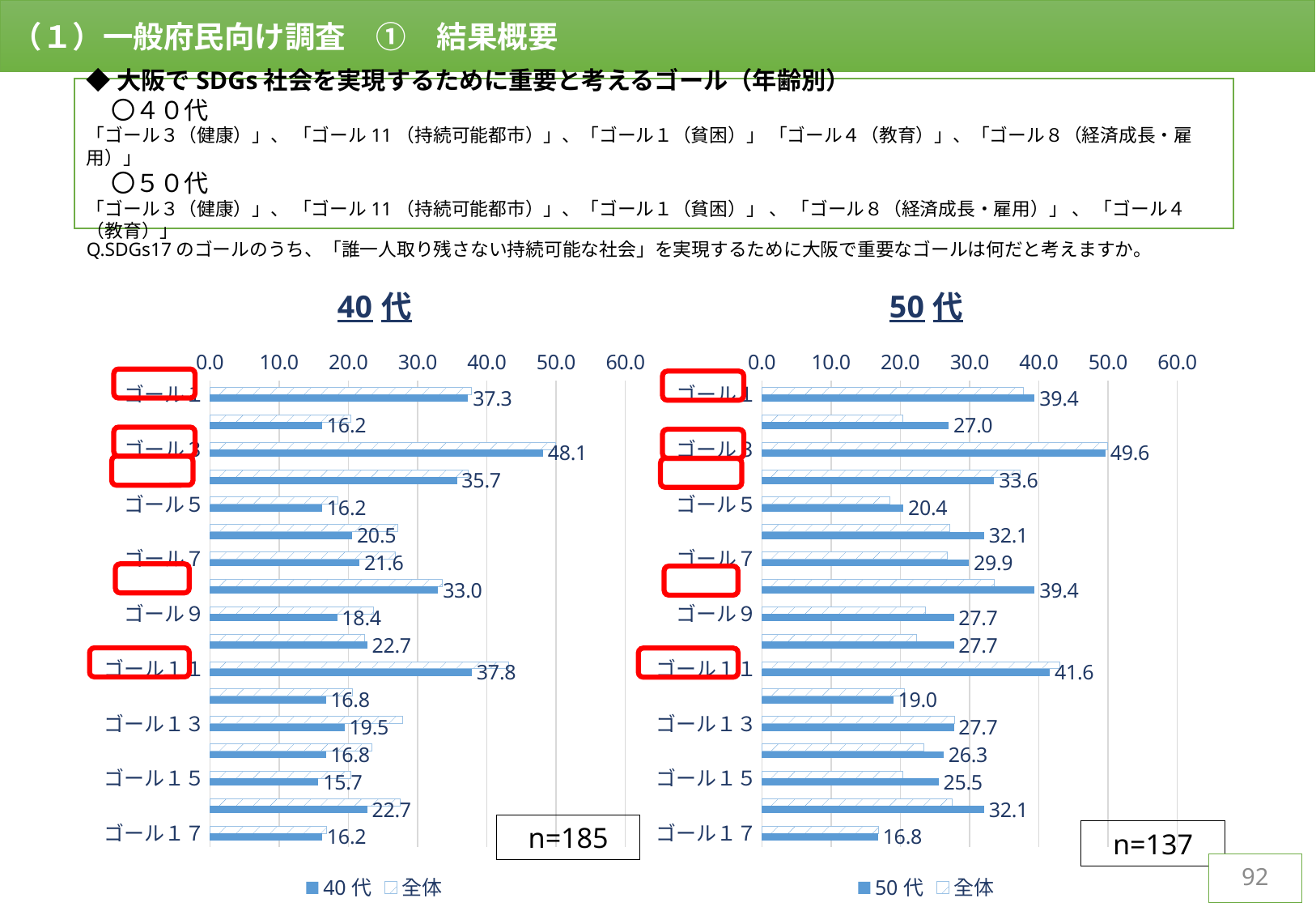
In the 40代 chart, what is the difference between the 40代 values for ゴール3 and ゴール1? 10.8 In the 40代 chart, what is the value for ゴール13 in the 40代 series? 19.5 In the 40代 chart, what is the value for ゴール11 in the 40代 series? 37.8 In the 50代 chart, is the 全体 value for ゴール17 greater or less than 20.0? less In the 50代 chart, what is the difference between the 50代 values for ゴール3 and ゴール11? 8.0 What sample size (n) is shown for the 50代 chart? n=137 In the 40代 chart, which goal has the highest value in the 40代 series? ゴール3 In the 50代 chart, which goal has the lowest value in the 50代 series? ゴール17 How many series does the legend of the 50代 chart list? 2 In the 50代 chart, what is the value for ゴール1 in the 50代 series? 39.4 In the 40代 chart, which is larger in the 40代 series: ゴール1 or ゴール11? ゴール11 What kind of chart is the 40代 chart on the left? bar chart